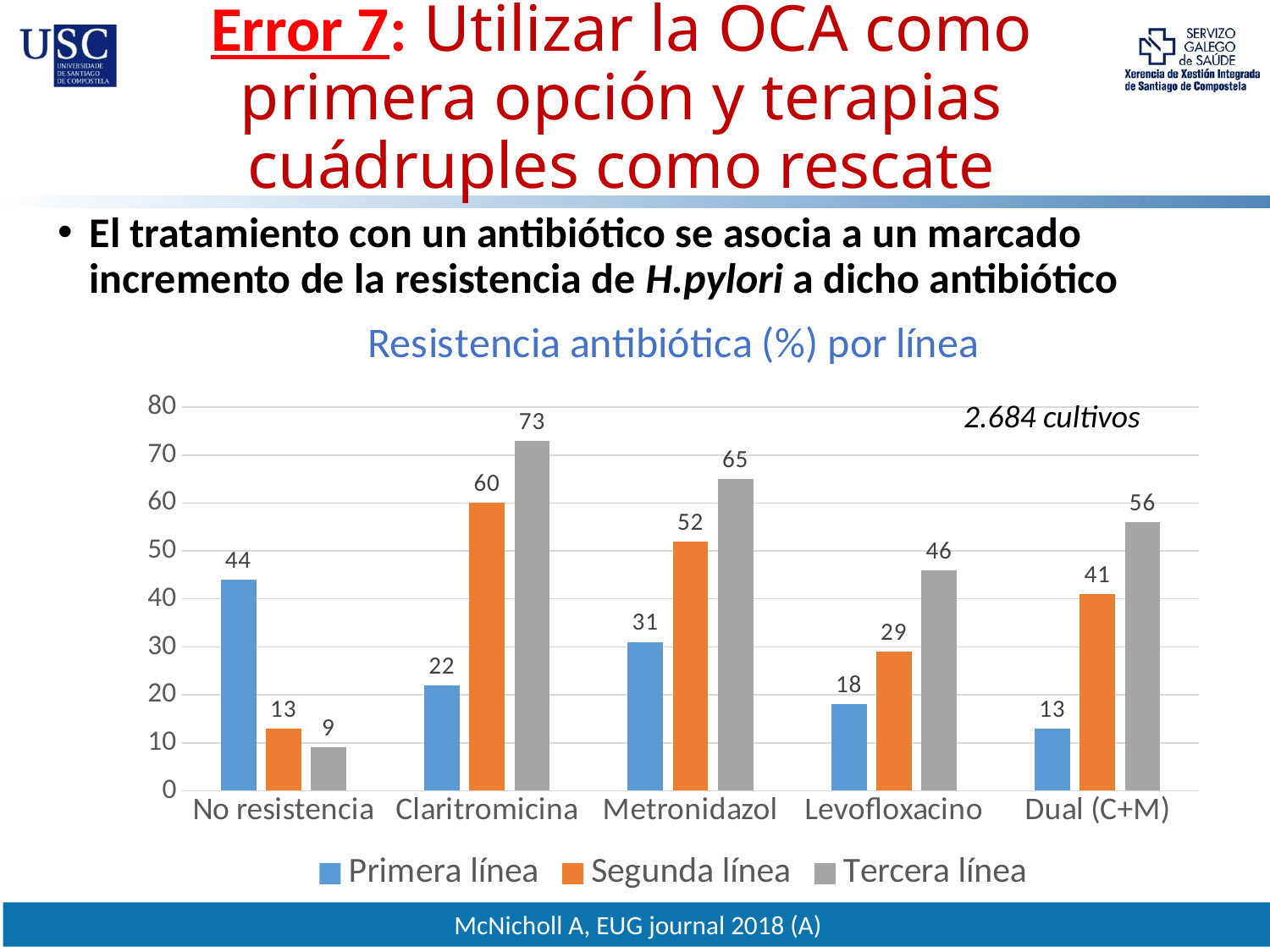
Which category has the highest value in the Tercera línea series? Claritromicina How many series does the legend list? 3 What is the value for Claritromicina in the Tercera línea series? 73 How many categories are shown on the x axis? 5 Which colour represents the Segunda línea series? Orange What is the difference between the Tercera línea and Primera línea values for Metronidazol? 34 What is the value for No resistencia in the Primera línea series? 44 Which category has the lowest value in the Primera línea series? Dual (C+M) What is the title of the chart? Resistencia antibiótica (%) por línea Which is larger for Dual (C+M): the Segunda línea value or the Tercera línea value? Tercera línea What kind of chart is shown on the slide? Bar chart What is the value for Levofloxacino in the Segunda línea series? 29